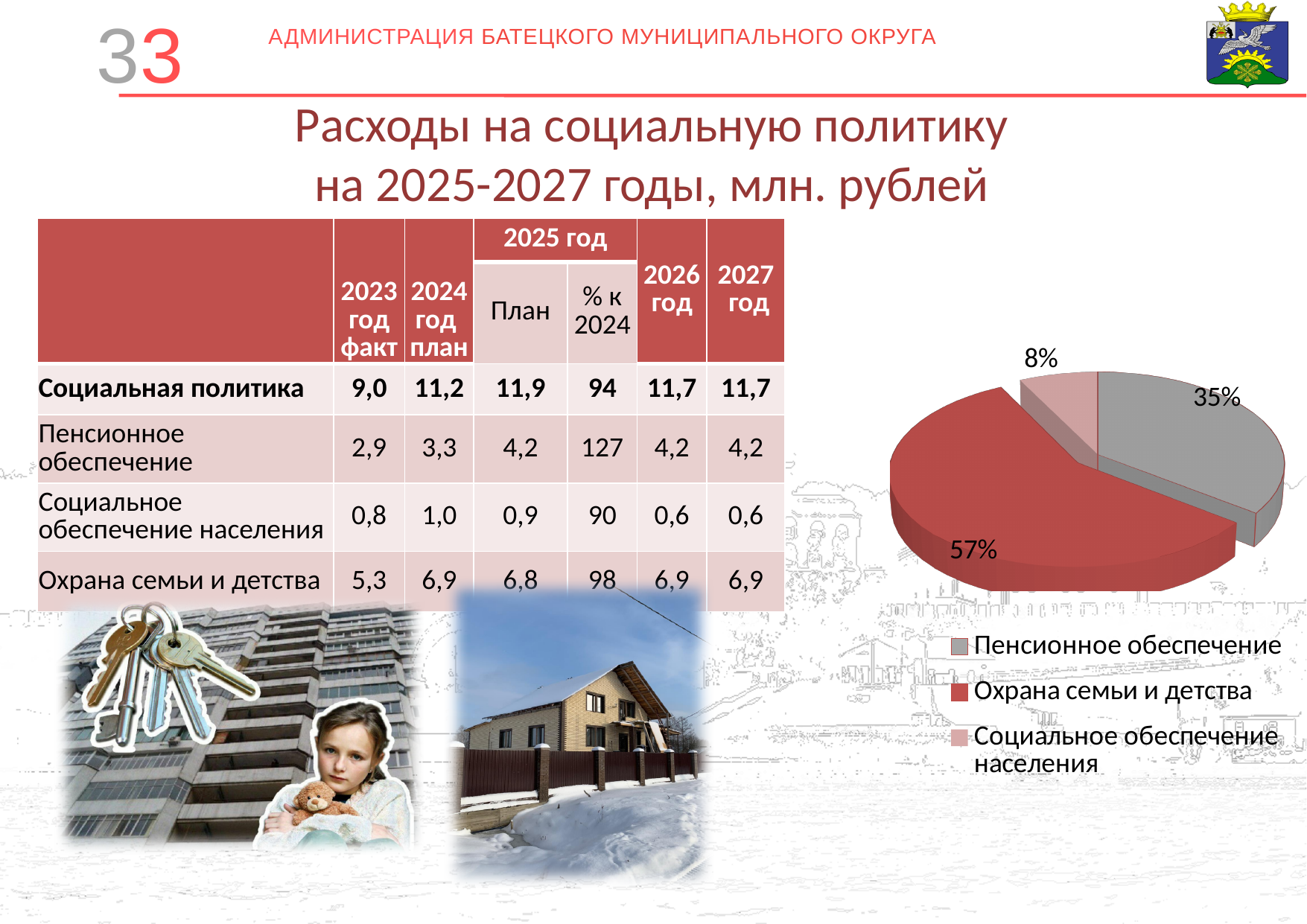
What kind of chart is shown on the right side of the slide? Pie chart In the pie chart, which is larger: Пенсионное обеспечение or Социальное обеспечение населения? Пенсионное обеспечение Which category has the largest slice in the pie chart? Охрана семьи и детства In the pie chart, what share does Охрана семьи и детства have? 57% How many slices does the pie chart have? 3 In the pie chart, what share does Пенсионное обеспечение have? 35% In the pie chart, what is the difference in percentage points between Охрана семьи и детства and Пенсионное обеспечение? 22 Which category has the smallest slice in the pie chart? Социальное обеспечение населения In the pie chart, what colour is the slice for Пенсионное обеспечение? Grey In the pie chart, what share does Социальное обеспечение населения have? 8% In the pie chart, what colour is the slice for Охрана семьи и детства? Red How many entries does the pie chart's legend list? 3